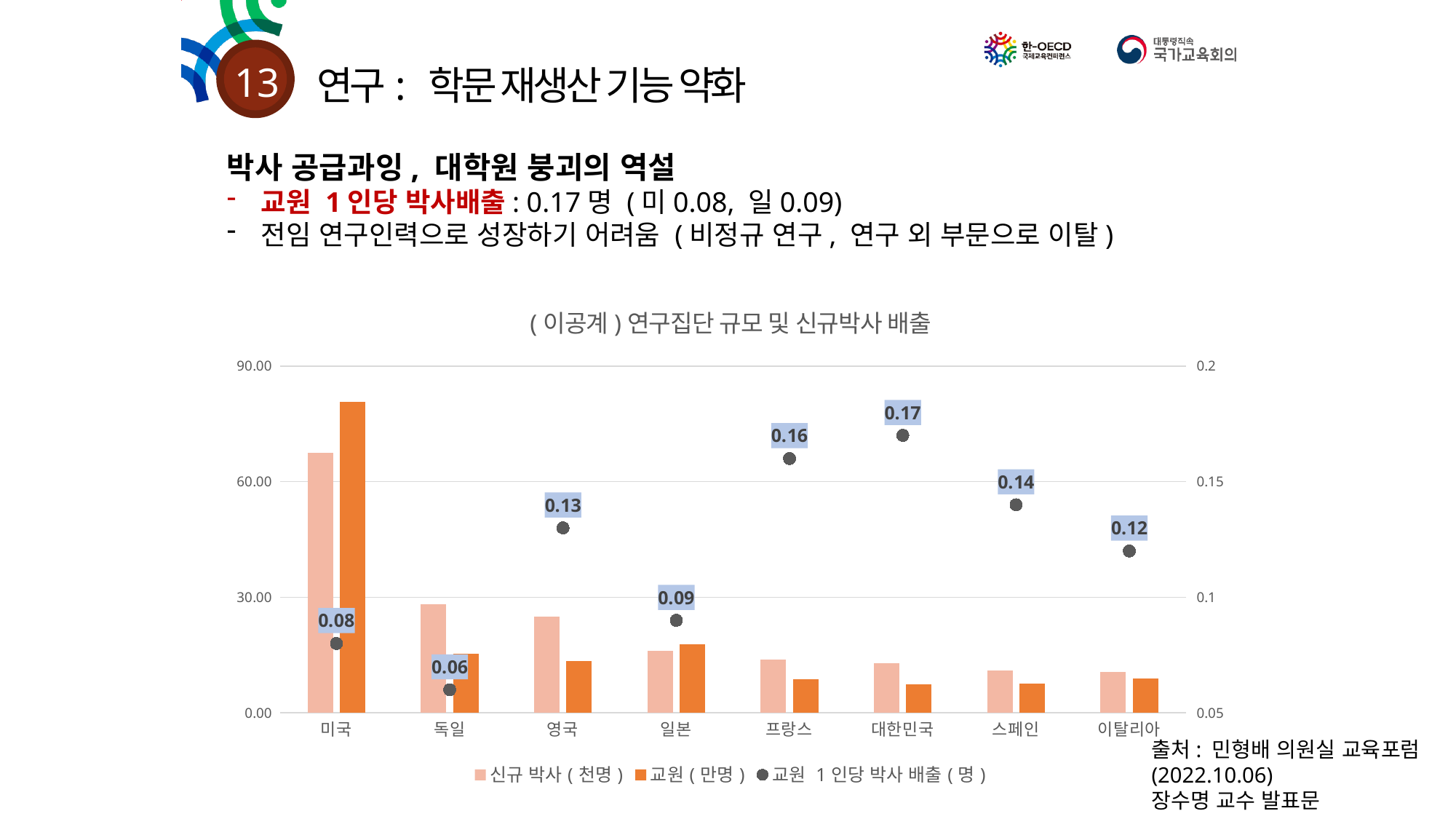
What is the value of 교원 1 인당 박사 배출 ( 명 ) for 대한민국? 0.17 What is the value of 교원 1 인당 박사 배출 ( 명 ) for 이탈리아? 0.12 Which has a larger 교원 1 인당 박사 배출 ( 명 ) value, 프랑스 or 영국? 프랑스 What is the title of the chart? ( 이공계 ) 연구집단 규모 및 신규박사 배출 Is the 교원 ( 만명 ) bar for 미국 greater or less than 60.00 on the left axis? greater How many series does the chart legend list? 3 Which country has the highest 교원 1 인당 박사 배출 ( 명 ) value? 대한민국 How many countries are shown on the x axis of the chart? 8 Which country has the lowest 교원 1 인당 박사 배출 ( 명 ) value? 독일 What is the value of 교원 1 인당 박사 배출 ( 명 ) for 미국? 0.08 Is the 신규 박사 ( 천명 ) bar for 독일 greater or less than 30.00 on the left axis? less What is the difference between the 교원 1 인당 박사 배출 ( 명 ) values for 대한민국 and 미국? 0.09